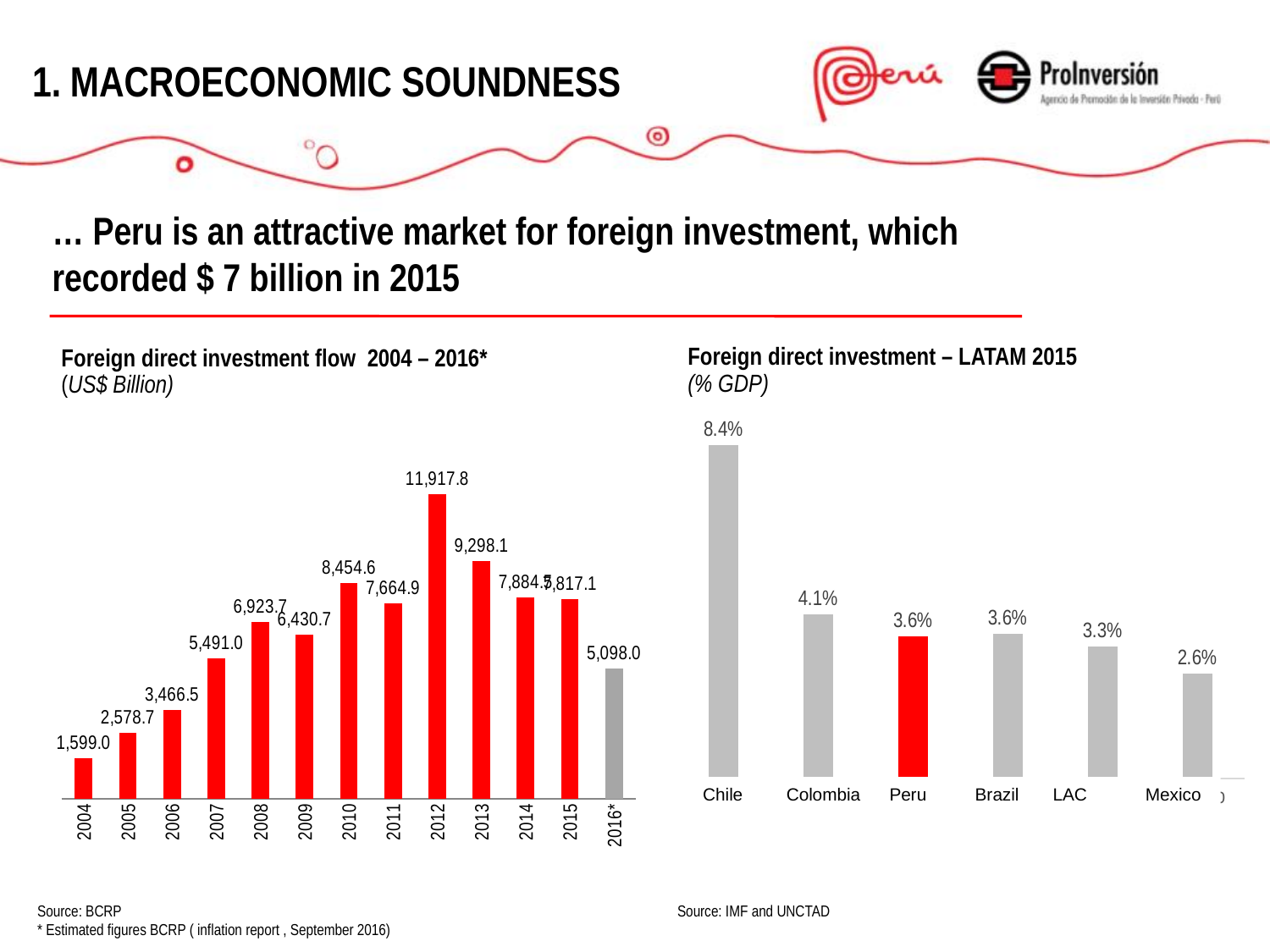
In the 'Foreign direct investment – LATAM 2015' chart, which is larger, Colombia or Peru? Colombia In the 'Foreign direct investment flow 2004 – 2016*' chart, what is the value for 2016*? 5,098.0 In the 'Foreign direct investment – LATAM 2015' chart, what is the difference between Chile and Colombia? 4.3% In the 'Foreign direct investment – LATAM 2015' chart, which country has the highest value? Chile In the 'Foreign direct investment flow 2004 – 2016*' chart, which year has the highest value? 2012 In the 'Foreign direct investment flow 2004 – 2016*' chart, what is the value for 2012? 11,917.8 In the 'Foreign direct investment flow 2004 – 2016*' chart, which year has the lowest value? 2004 How many years are shown in the 'Foreign direct investment flow 2004 – 2016*' chart? 13 In the 'Foreign direct investment flow 2004 – 2016*' chart, what is the difference between the 2012 and 2013 values? 2,619.7 What type of chart is the 'Foreign direct investment – LATAM 2015' chart? Bar chart In the 'Foreign direct investment – LATAM 2015' chart, which category has the lowest value? Mexico In the 'Foreign direct investment – LATAM 2015' chart, what is the value for Chile? 8.4%